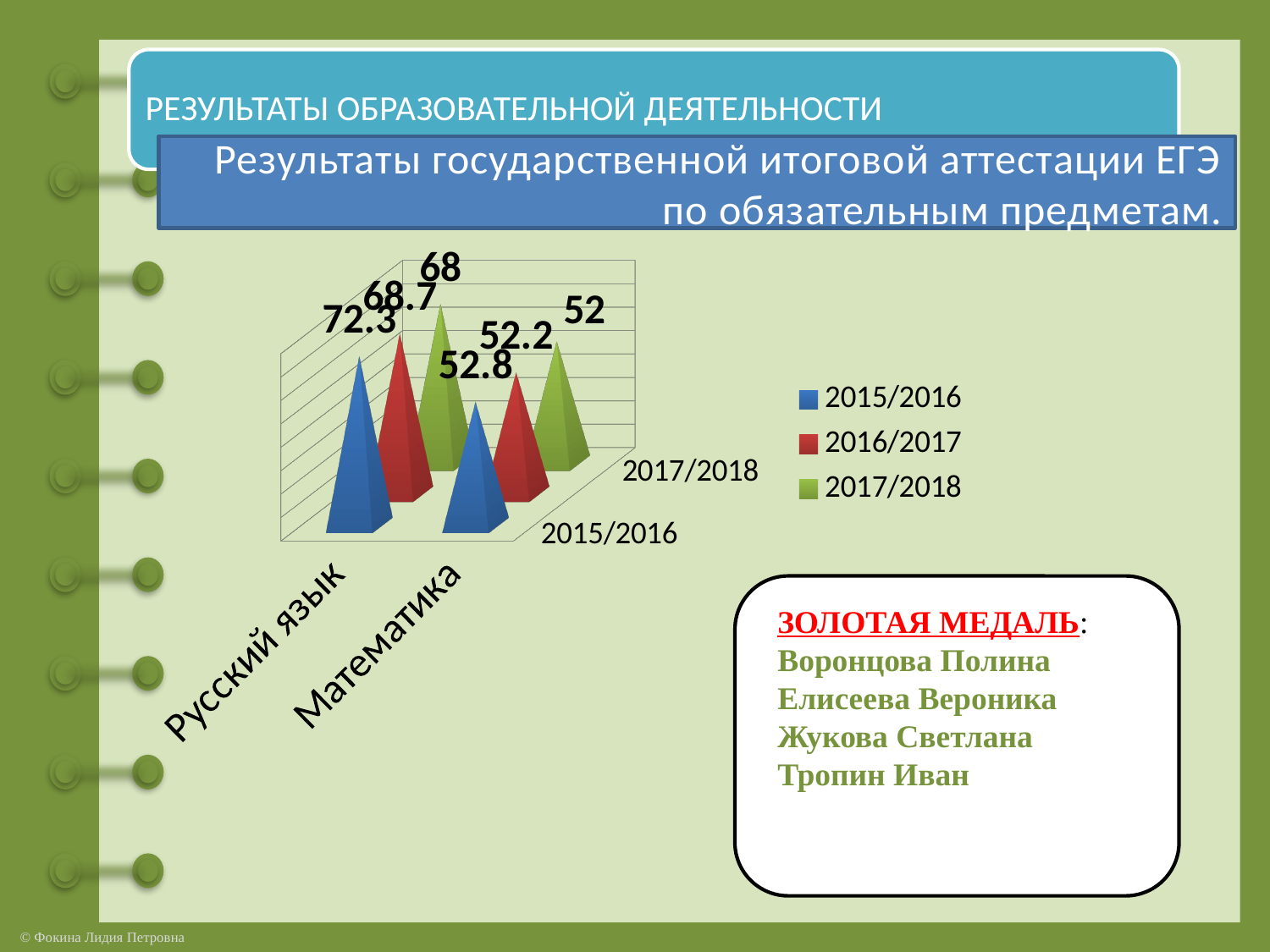
What is the value for Русский язык in 2017/2018? 68 How many series does the legend list? 3 What is the value for Математика in 2017/2018? 52 What is the value for Русский язык in 2016/2017? 68.7 What is the value for Математика in 2015/2016? 52.8 What is the value for Математика in 2016/2017? 52.2 Which is larger: the 2015/2016 value for Русский язык or the 2015/2016 value for Математика? Русский язык Which year has the highest value for Русский язык? 2015/2016 How many subject categories are shown on the chart? 2 What is the value for Русский язык in 2015/2016? 72.3 Do the values for Математика rise or fall from 2015/2016 to 2017/2018? fall What is the difference between the Русский язык values for 2015/2016 and 2017/2018? 4.3